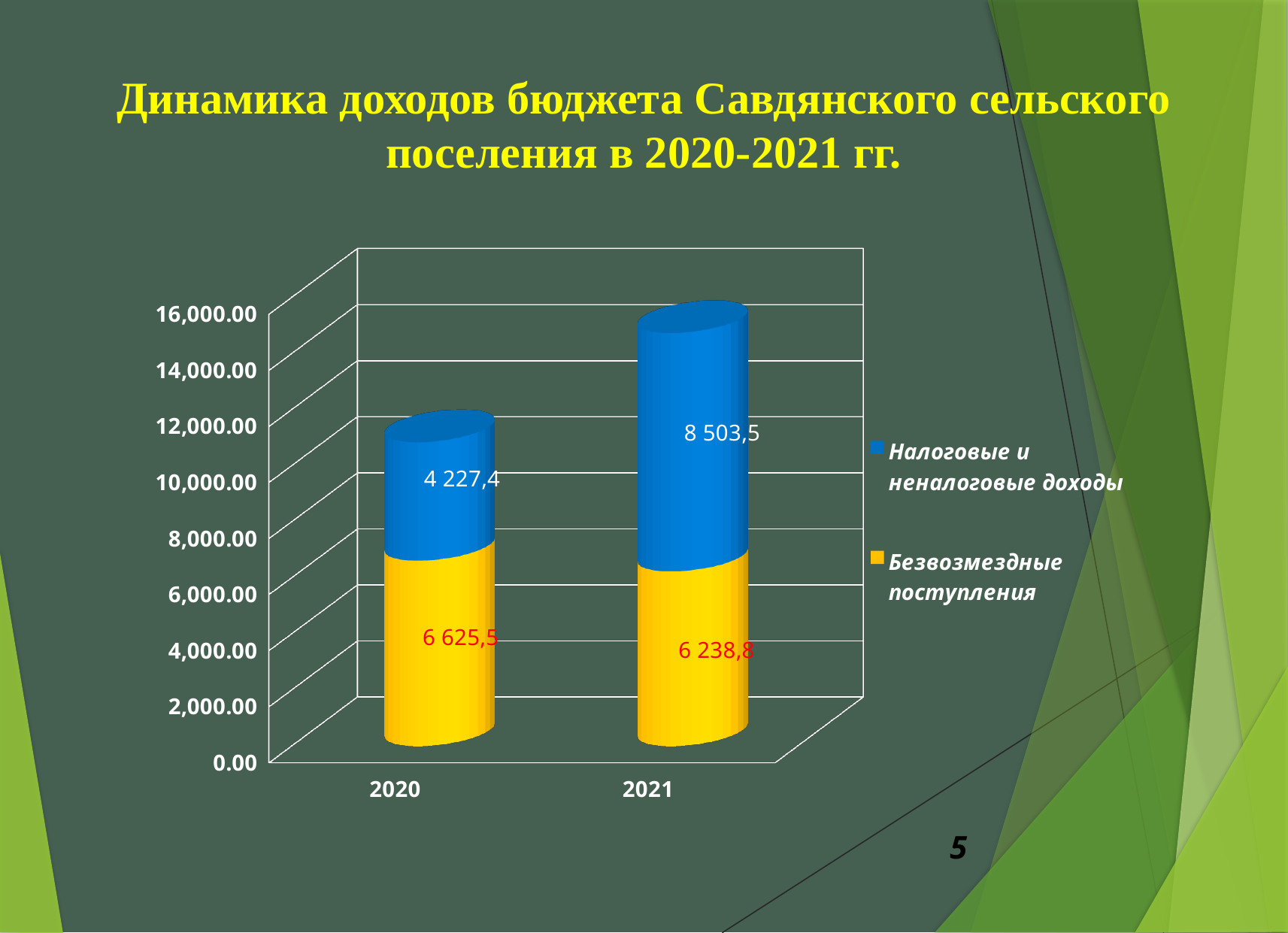
What is the difference between the Безвозмездные поступления values for 2020 and 2021? 386,7 What kind of chart is shown on the slide? Stacked bar chart What is the value of Налоговые и неналоговые доходы for 2020? 4 227,4 Which year has the higher value for Налоговые и неналоговые доходы, 2020 or 2021? 2021 What is the total of the stacked bar for 2020? 10 852,9 How many series does the legend list? 2 What is the difference between the Налоговые и неналоговые доходы values for 2021 and 2020? 4 276,1 What is the value of Налоговые и неналоговые доходы for 2021? 8 503,5 What is the value of Безвозмездные поступления for 2021? 6 238,8 What is the total of the stacked bar for 2021? 14 742,3 What is the value of Безвозмездные поступления for 2020? 6 625,5 Which year has the lower value for Безвозмездные поступления? 2021